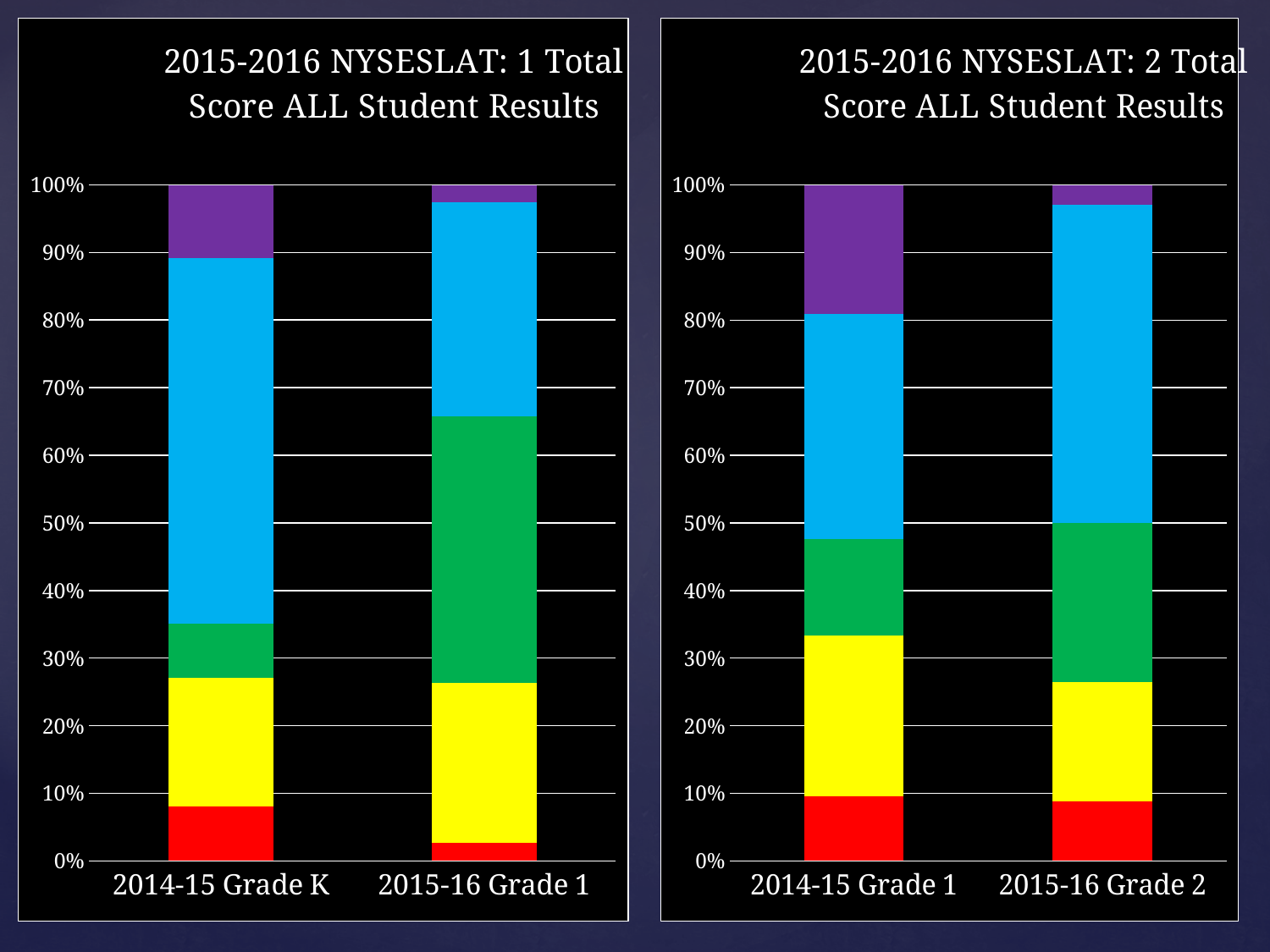
In the left chart, which bar has the larger purple segment, 2014-15 Grade K or 2015-16 Grade 1? 2014-15 Grade K What kind of chart is the left chart, titled '2015-2016 NYSESLAT: 1 Total Score ALL Student Results'? Stacked bar chart How many categories are shown on the x axis of the right chart, titled '2015-2016 NYSESLAT: 2 Total Score ALL Student Results'? 2 In the left chart, how many coloured segments make up each stacked bar? 5 In the left chart, is the top of the yellow segment for 2015-16 Grade 1 greater or less than 30%? less In the right chart, which bar has the larger green segment, 2014-15 Grade 1 or 2015-16 Grade 2? 2015-16 Grade 2 In the right chart, is the top of the yellow segment for 2014-15 Grade 1 greater or less than 30%? greater In the left chart, what is the total height of the stacked bar for 2014-15 Grade K? 100% In the right chart, is the top of the blue segment for 2015-16 Grade 2 greater or less than 90%? greater What are the two x-axis category labels on the right chart? 2014-15 Grade 1 and 2015-16 Grade 2